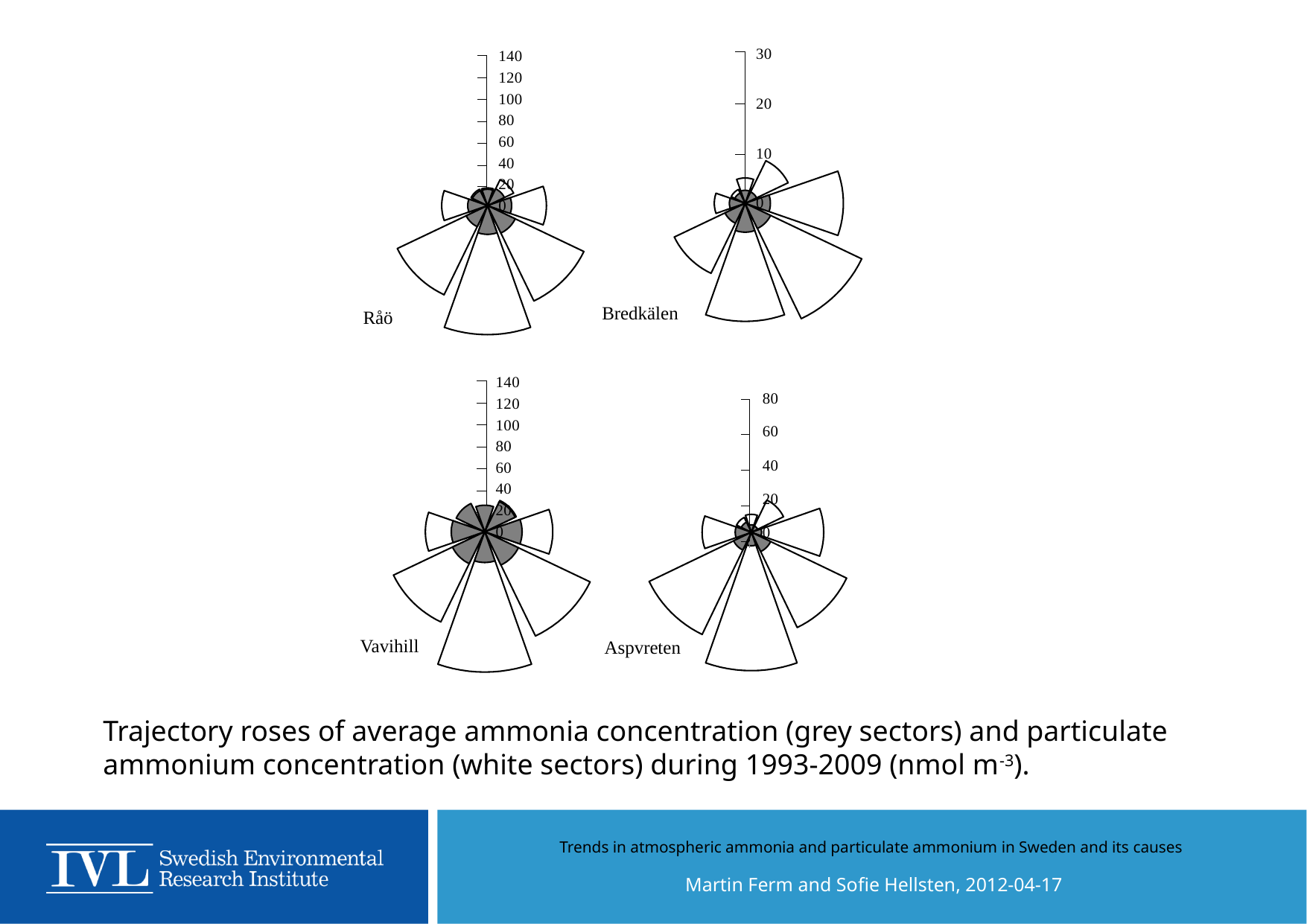
What is the highest value shown on the radial axis of the Råö chart? 140 According to the caption, what do the grey sectors in the roses represent? Average ammonia concentration What is the highest value shown on the radial axis of the Bredkälen chart? 30 In the Bredkälen chart, is the value of the grey sectors greater or less than 10? less What is the highest value shown on the radial axis of the Aspvreten chart? 80 In the Råö chart, is the value of the southern white sector greater or less than 80? greater What kind of chart is used for each station on the slide? Rose (polar) chart How many trajectory rose charts are shown on the slide? 4 In the Vavihill chart, is the value of the southern white sector greater or less than 100? greater Which station's chart has the smallest radial axis maximum? Bredkälen What unit is given in the caption for the concentrations shown in the roses? nmol m-3